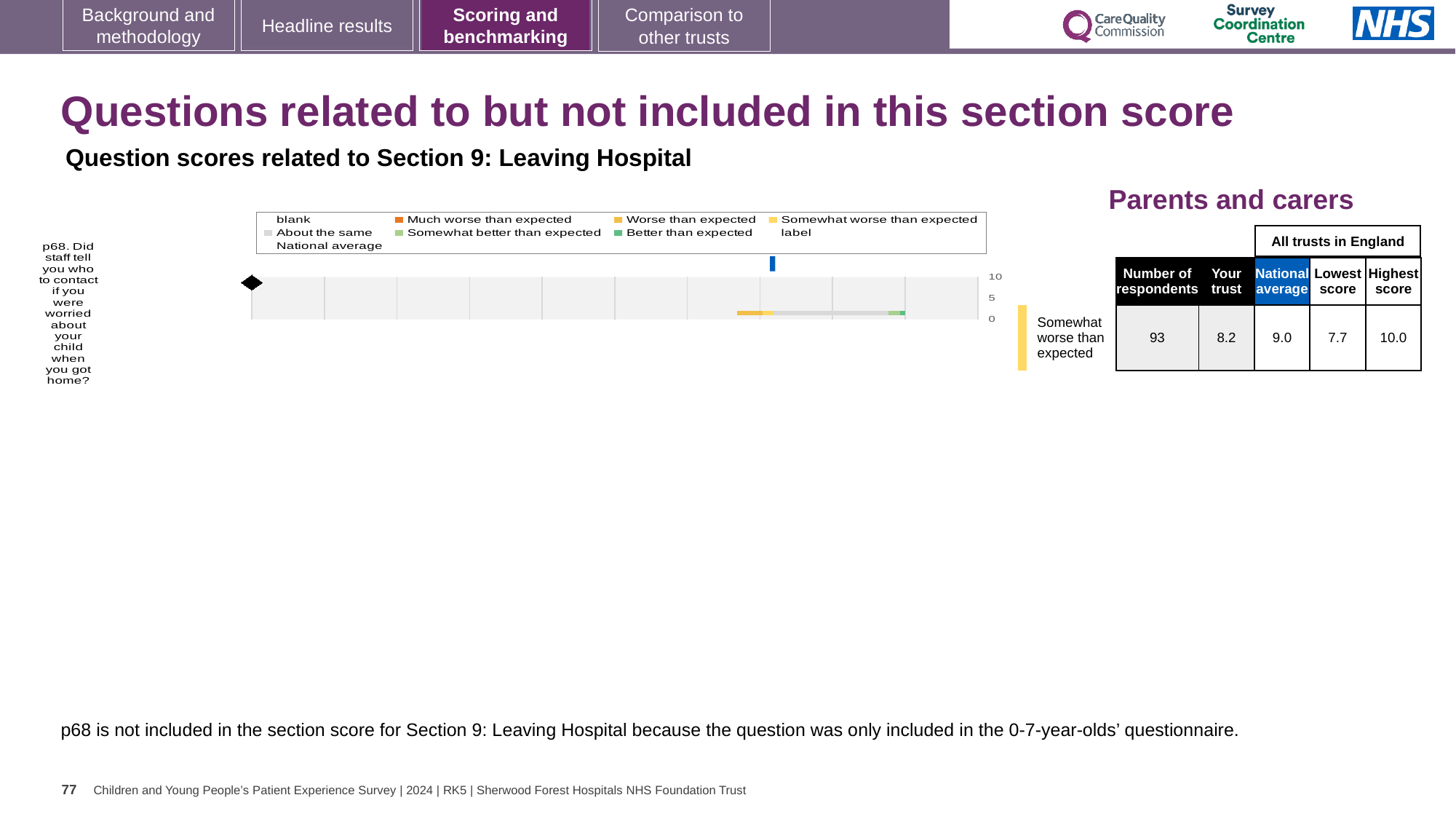
In the table next to the chart, how many respondents answered p68? 93 What kind of chart is shown on the slide for question p68? Bar chart Is the national average marker for p68 on the chart greater or less than 5? greater How many survey questions are plotted in the chart? 1 Which benchmark category is the trust's result for p68 labelled as, according to the label next to the chart? Somewhat worse than expected In the table next to the chart, what is the national average score for p68? 9.0 In the table next to the chart, what is the difference between the national average and the trust's score for p68? 0.8 In the table next to the chart, which is larger for p68: the trust's score or the national average? National average In the table next to the chart, what is the difference between the highest score and the lowest score for p68? 2.3 How many entries does the chart legend list? 9 In the table next to the chart, what is the 'Your trust' score for p68? 8.2 What is the highest value shown on the chart's axis? 10